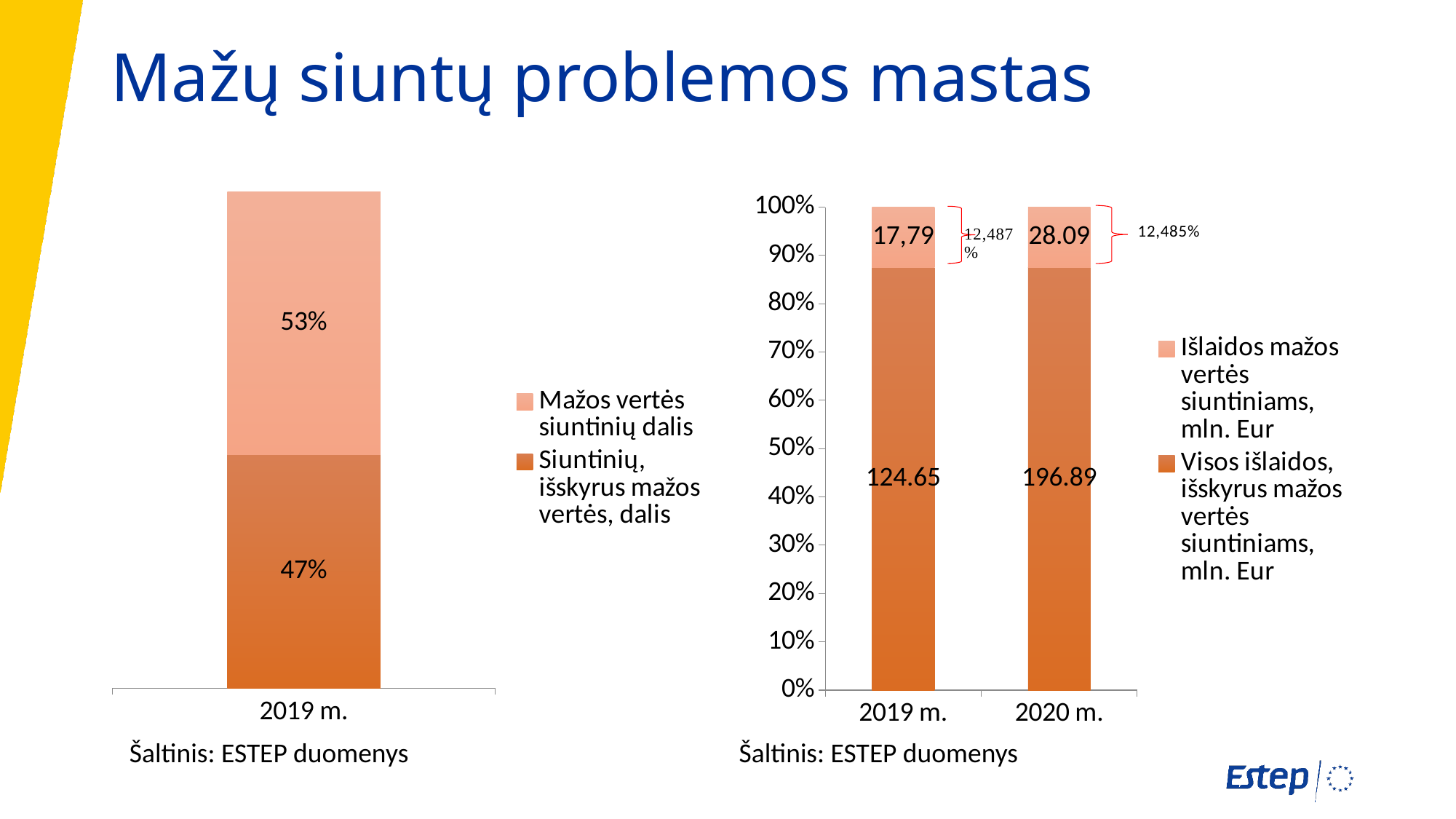
In the right chart, how many categories are shown on the x axis? 2 In the right chart, what is the value of Išlaidos mažos vertės siuntiniams, mln. Eur for 2020 m.? 28.09 In the right chart, what is the value of Išlaidos mažos vertės siuntiniams, mln. Eur for 2019 m.? 17,79 In the left chart, which segment is larger for 2019 m.: Mažos vertės siuntinių dalis or Siuntinių, išskyrus mažos vertės, dalis? Mažos vertės siuntinių dalis In the left chart, what is the value labelled on the lighter segment (Mažos vertės siuntinių dalis) for 2019 m.? 53% In the left chart, how many series does the legend list? 2 In the left chart, what is the value labelled on the darker segment (Siuntinių, išskyrus mažos vertės, dalis) for 2019 m.? 47% What kind of chart is the left chart? Stacked bar chart In the right chart, do the Visos išlaidos, išskyrus mažos vertės siuntiniams values rise or fall from 2019 m. to 2020 m.? Rise In the right chart, what is the value of Visos išlaidos, išskyrus mažos vertės siuntiniams, mln. Eur for 2019 m.? 124.65 In the right chart, what is the difference between the Visos išlaidos, išskyrus mažos vertės siuntiniams values for 2020 m. and 2019 m.? 72.24 In the right chart, what is the value of Visos išlaidos, išskyrus mažos vertės siuntiniams, mln. Eur for 2020 m.? 196.89